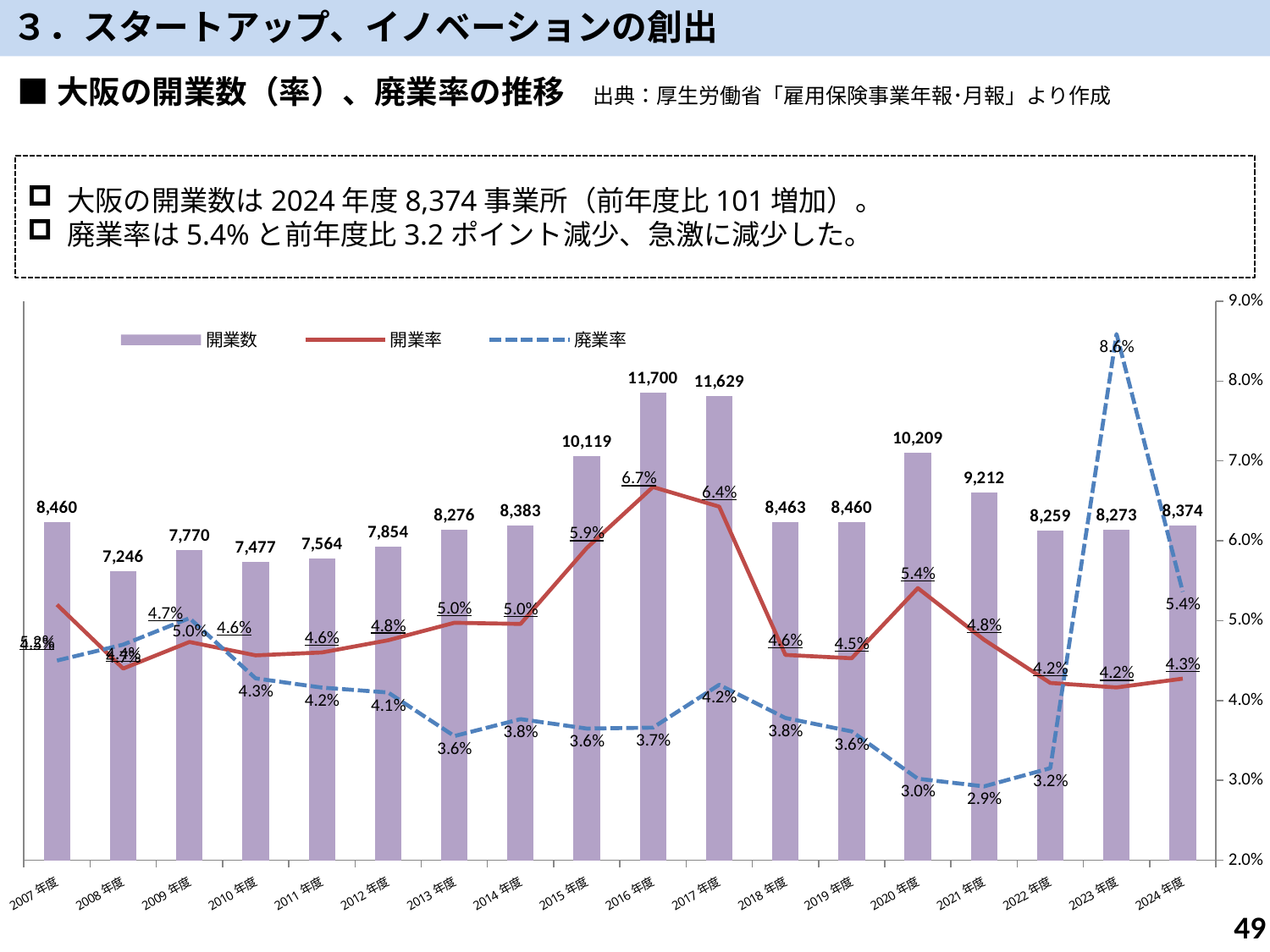
Which is larger, the 開業数 for 2020年度 or for 2021年度? 2020年度 What is the 廃業率 for 2023年度? 8.6% Which year has the highest 開業数? 2016年度 What is the 開業率 for 2016年度? 6.7% How many series does the legend list? 3 What is the difference in 開業数 between 2024年度 and 2023年度? 101 What is the value of 開業数 for 2016年度? 11,700 Which year has the lowest 廃業率? 2021年度 What is the value of 開業数 for 2024年度? 8,374 Which series is drawn as a dashed line? 廃業率 How many years are shown on the x axis? 18 Is the 廃業率 for 2024年度 greater or less than 5.0%? greater